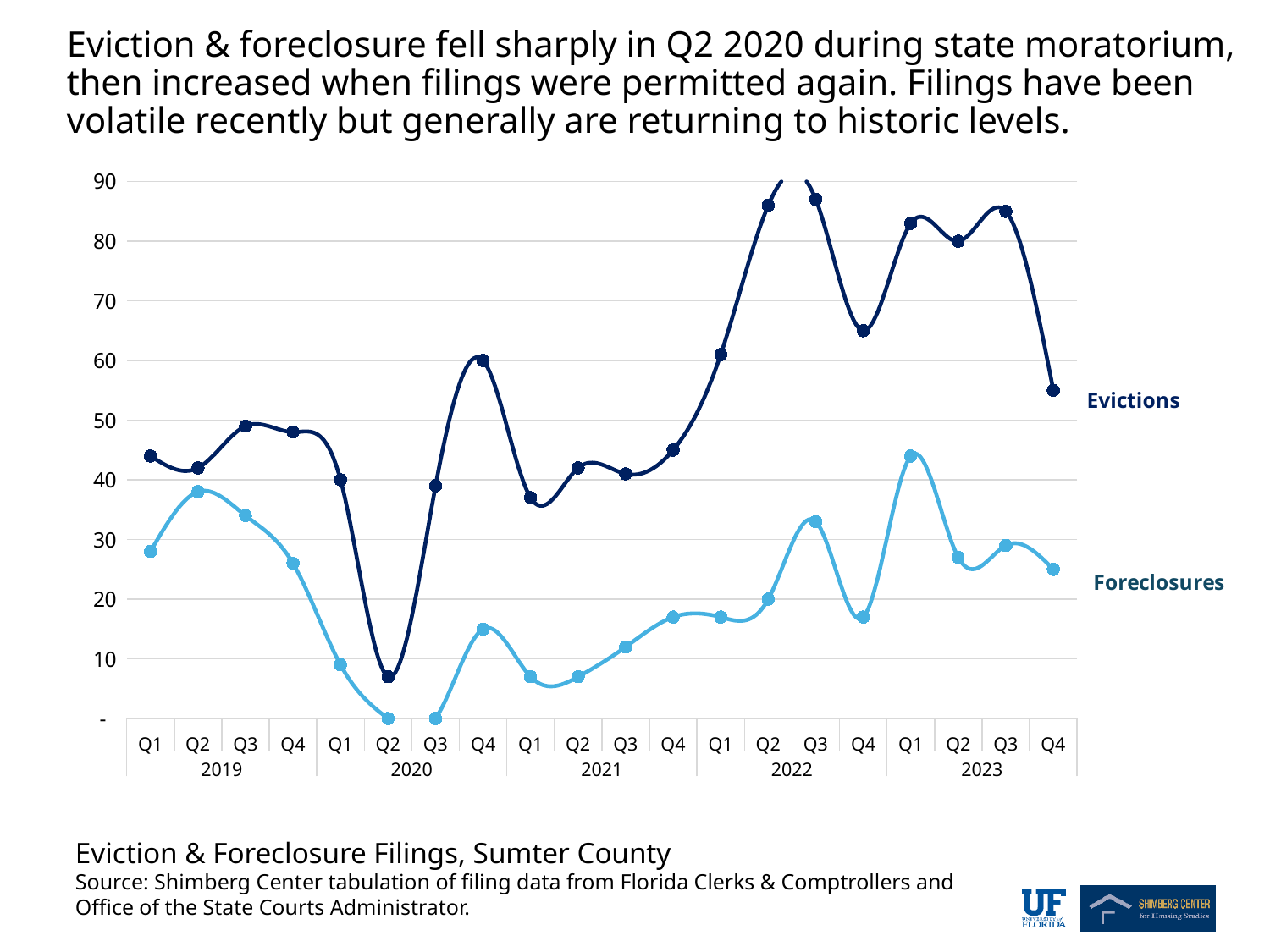
Do Evictions rise or fall from Q1 2020 to Q2 2020? Fall What is the title of the chart given below the plot? Eviction & Foreclosure Filings, Sumter County Which series has the higher value in Q1 2023, Evictions or Foreclosures? Evictions What kind of chart is shown on the slide? Line chart Is the Foreclosures value for Q4 2023 greater or less than 30? less In which quarter does the Foreclosures line reach its highest value? Q1 2023 Is the Evictions value for Q4 2022 greater or less than 60? greater In which quarter does the Evictions line reach its lowest value? Q2 2020 How many quarterly data points does each line cover on the x axis? 20 Which is larger, the Foreclosures value in Q2 2019 or in Q4 2019? Q2 2019 Is the Evictions value for Q4 2023 greater or less than 50? greater How many series are plotted on the chart? 2